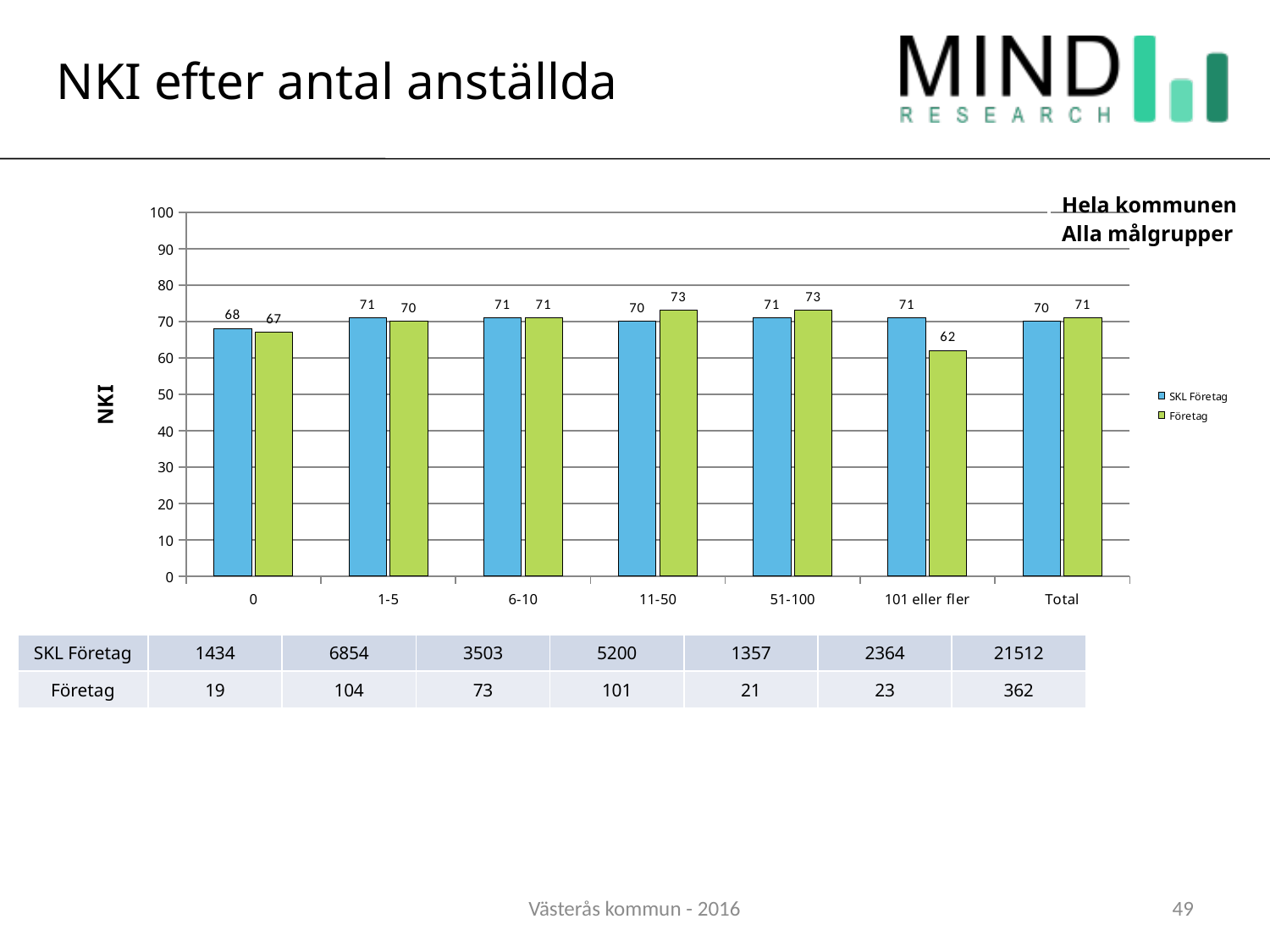
What is the NKI value for Företag in the '11-50' category? 73 In the '11-50' category, which series has the higher NKI value, SKL Företag or Företag? Företag How many series does the chart legend list? 2 What is the difference between the SKL Företag and Företag values in the '101 eller fler' category? 9 What is the NKI value for SKL Företag in the 'Total' category? 70 What is the label of the y axis of the chart? NKI How many categories are shown on the x axis of the chart? 7 Which category has the lowest NKI value for Företag? 101 eller fler What kind of chart is shown on the slide? Bar chart What is the NKI value for Företag in the '101 eller fler' category? 62 Which category has the lowest NKI value for SKL Företag? 0 What is the NKI value for SKL Företag in the '0' category? 68